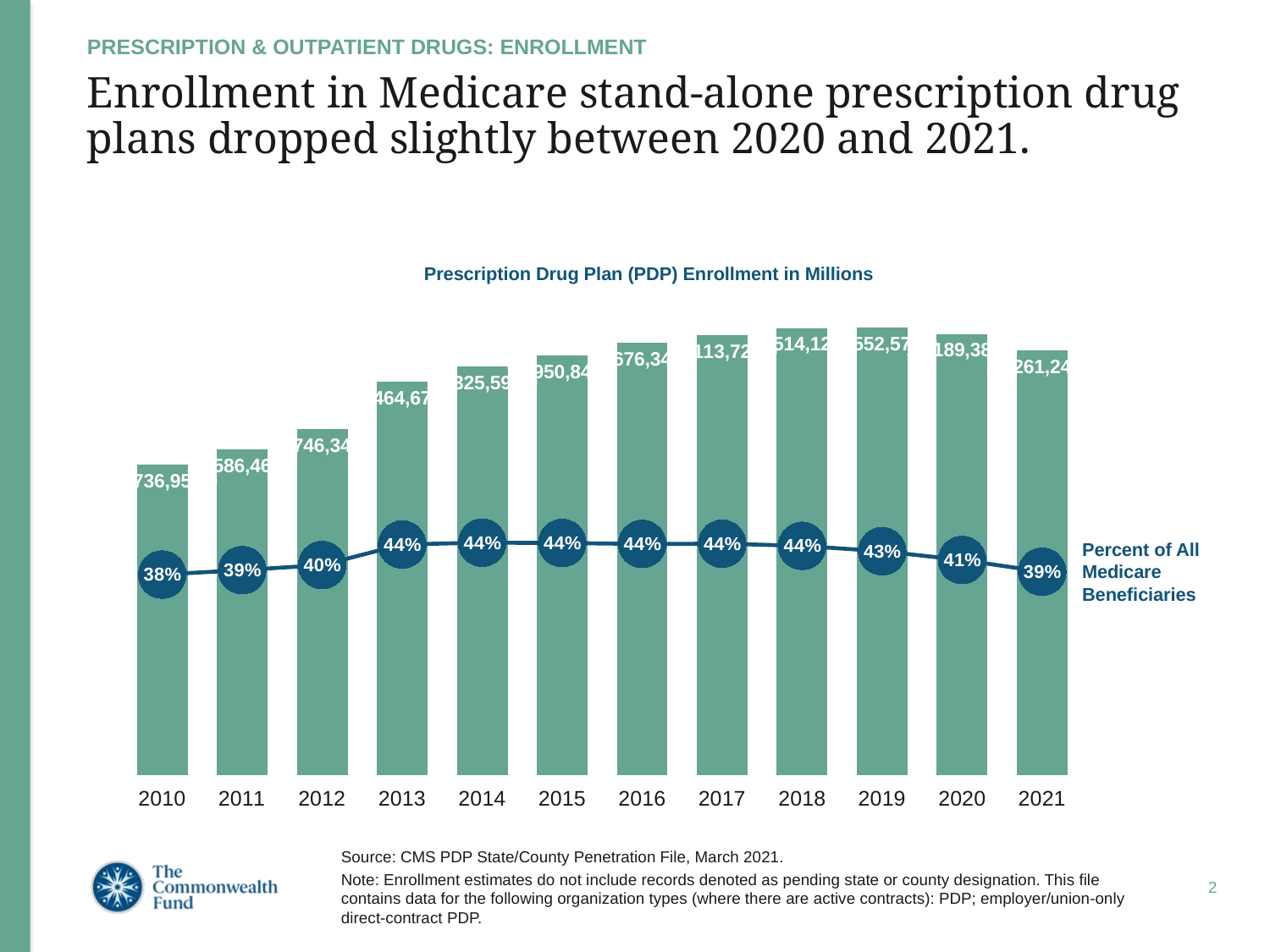
By how many percentage points did the percent of all Medicare beneficiaries enrolled in PDPs fall from 2020 to 2021? 2 percentage points What is the title of the chart? Prescription Drug Plan (PDP) Enrollment in Millions How many years are shown on the x axis of the chart? 12 Which year has the lowest percent of all Medicare beneficiaries enrolled in PDPs? 2010 What kind of chart is used to show PDP enrollment? Bar chart What is the highest percent of all Medicare beneficiaries shown on the line? 44% What percent of all Medicare beneficiaries were enrolled in stand-alone prescription drug plans in 2019? 43% What percent of all Medicare beneficiaries were enrolled in stand-alone prescription drug plans in 2010? 38% What percent of all Medicare beneficiaries were enrolled in stand-alone prescription drug plans in 2021? 39% Does the percent of all Medicare beneficiaries enrolled in PDPs rise or fall from 2018 to 2021? Fall What percent of all Medicare beneficiaries were enrolled in stand-alone prescription drug plans in 2012? 40% Which year has the taller enrollment bar, 2010 or 2019? 2019